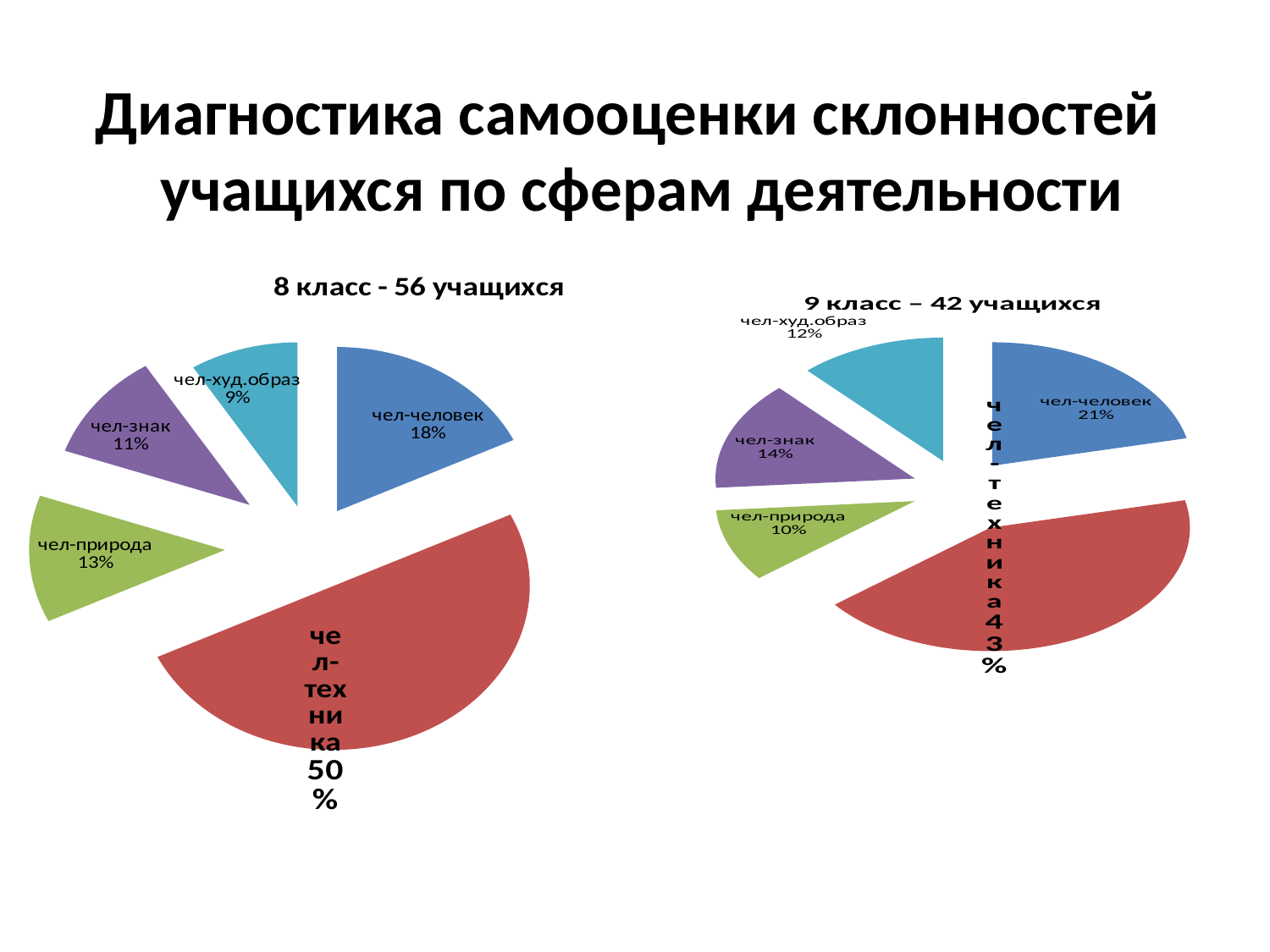
In the chart titled "8 класс - 56 учащихся", which category has the largest slice? чел-техника In the chart titled "9 класс – 42 учащихся", what share does "чел-человек" have? 21% How many categories does the chart titled "8 класс - 56 учащихся" show? 5 In the chart titled "9 класс – 42 учащихся", which category has the smallest slice? чел-природа What kind of chart is the chart on the right of the slide? pie chart In the chart titled "9 класс – 42 учащихся", what is the difference between "чел-техника" and "чел-человек"? 22% In the chart titled "8 класс - 56 учащихся", what is the difference between "чел-человек" and "чел-знак"? 7% In the chart titled "9 класс – 42 учащихся", which is larger, "чел-худ.образ" or "чел-природа"? чел-худ.образ In the chart titled "8 класс - 56 учащихся", what share does the slice "чел-техника" have? 50% In the chart titled "8 класс - 56 учащихся", which category has the smallest slice? чел-худ.образ In the chart titled "9 класс – 42 учащихся", what is the value for "чел-знак"? 14% In the chart titled "8 класс - 56 учащихся", what is the value for "чел-худ.образ"? 9%